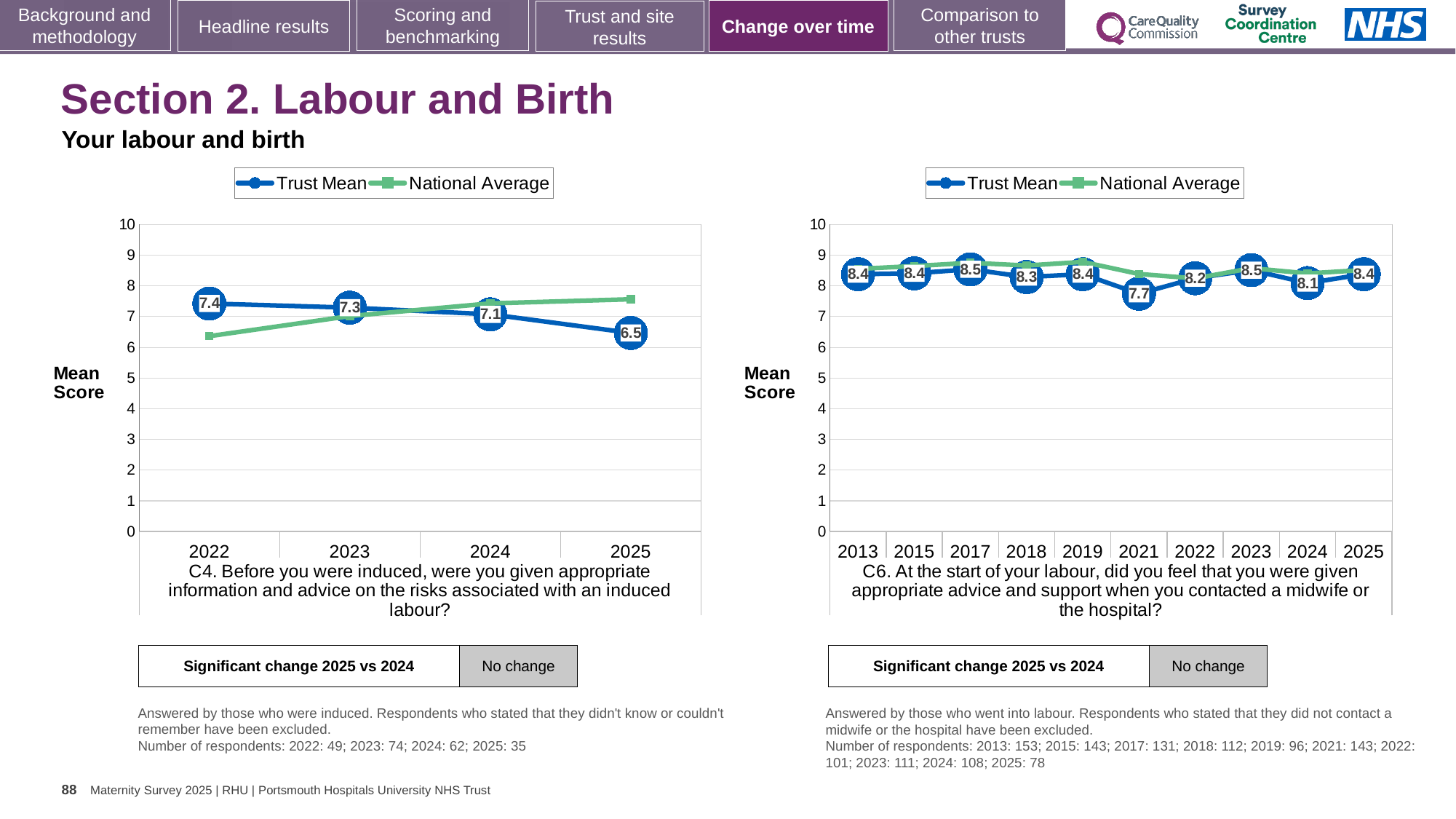
In the left chart (C4), how many years are shown on the x axis? 4 In the right chart (C6), how many years are shown on the x axis? 10 In the left chart (C4), is the National Average for 2022 greater or less than 7? less In the right chart (C6), which year has the lowest Trust Mean score? 2021 In the left chart (C4), what is the Trust Mean score for 2025? 6.5 In the right chart (C6), what is the Trust Mean score for 2021? 7.7 In the right chart (C6), which is larger, the Trust Mean for 2024 or for 2025? 2025 How many series does the legend of the right chart (C6) list? 2 In the left chart (C4), which year has the lowest Trust Mean score? 2025 In the left chart (C4), what is the difference between the Trust Mean scores for 2022 and 2025? 0.9 In the left chart (C4), what is the Trust Mean score for 2022? 7.4 In the left chart (C4), does the Trust Mean rise or fall from 2022 to 2025? fall